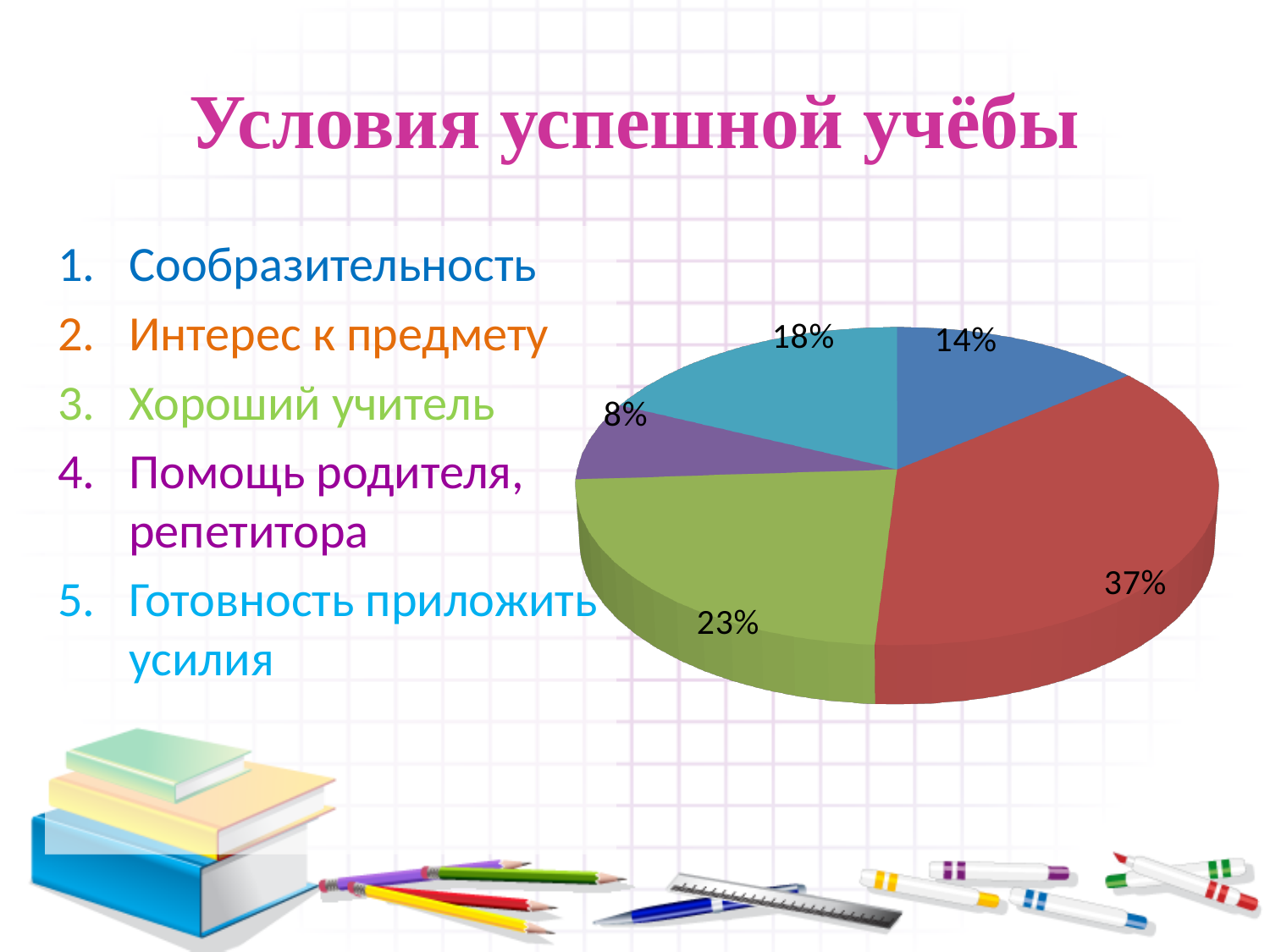
What is the difference between the largest slice (37%) and the smallest slice (8%) in the pie chart? 29 percentage points What percentage is shown for the blue slice of the pie chart? 14% What is the combined share of the slices labelled 14% and 18%? 32% What percentage is shown for the green slice of the pie chart? 23% What colour is the slice labelled 37% in the pie chart? red What percentage is shown for the purple slice of the pie chart? 8% How many slices does the pie chart have? 5 What kind of chart is shown on the slide? pie chart What is the title of the slide containing the pie chart? Условия успешной учёбы Which is larger in the pie chart: the slice labelled 18% or the slice labelled 23%? 23% What is the smallest share shown in the pie chart? 8% What is the largest share shown in the pie chart? 37%